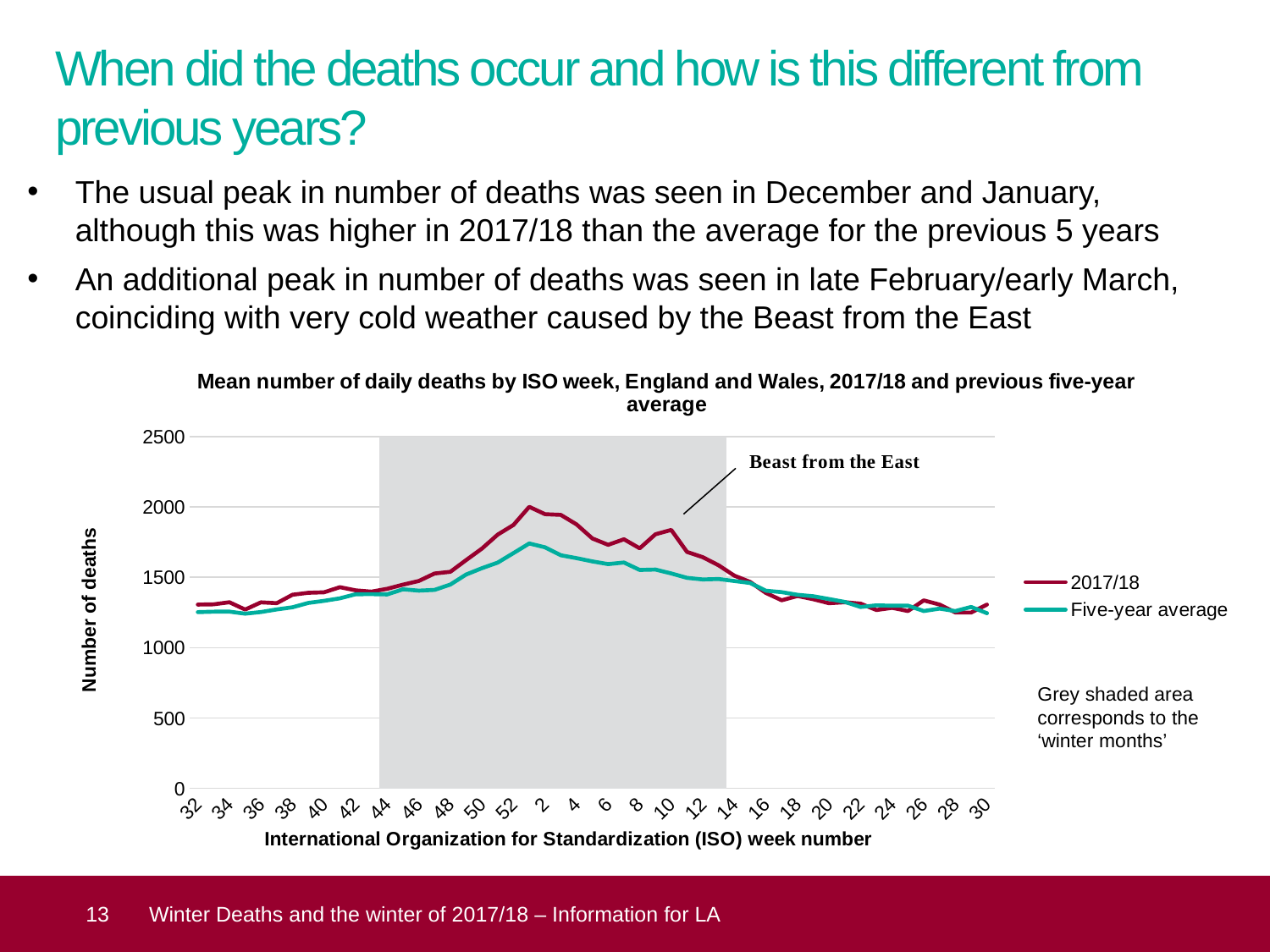
Is the Five-year average value at ISO week 30 greater or less than 1000? greater At ISO week 2, which series has the higher value, 2017/18 or Five-year average? 2017/18 Does the 2017/18 line rise or fall between ISO week 2 and ISO week 16? fall Is the peak value of the 2017/18 line greater or less than 1500? greater Is the 2017/18 value at ISO week 32 greater or less than 1500? less How many series does the chart legend list? 2 What is the highest value shown on the y axis of the chart? 2500 What does the grey shaded area on the chart correspond to, according to the note? The 'winter months' What kind of chart is shown on the slide? Line chart Does the 2017/18 line rise or fall between ISO week 32 and ISO week 52? rise What are the two series named in the chart legend? 2017/18 and Five-year average